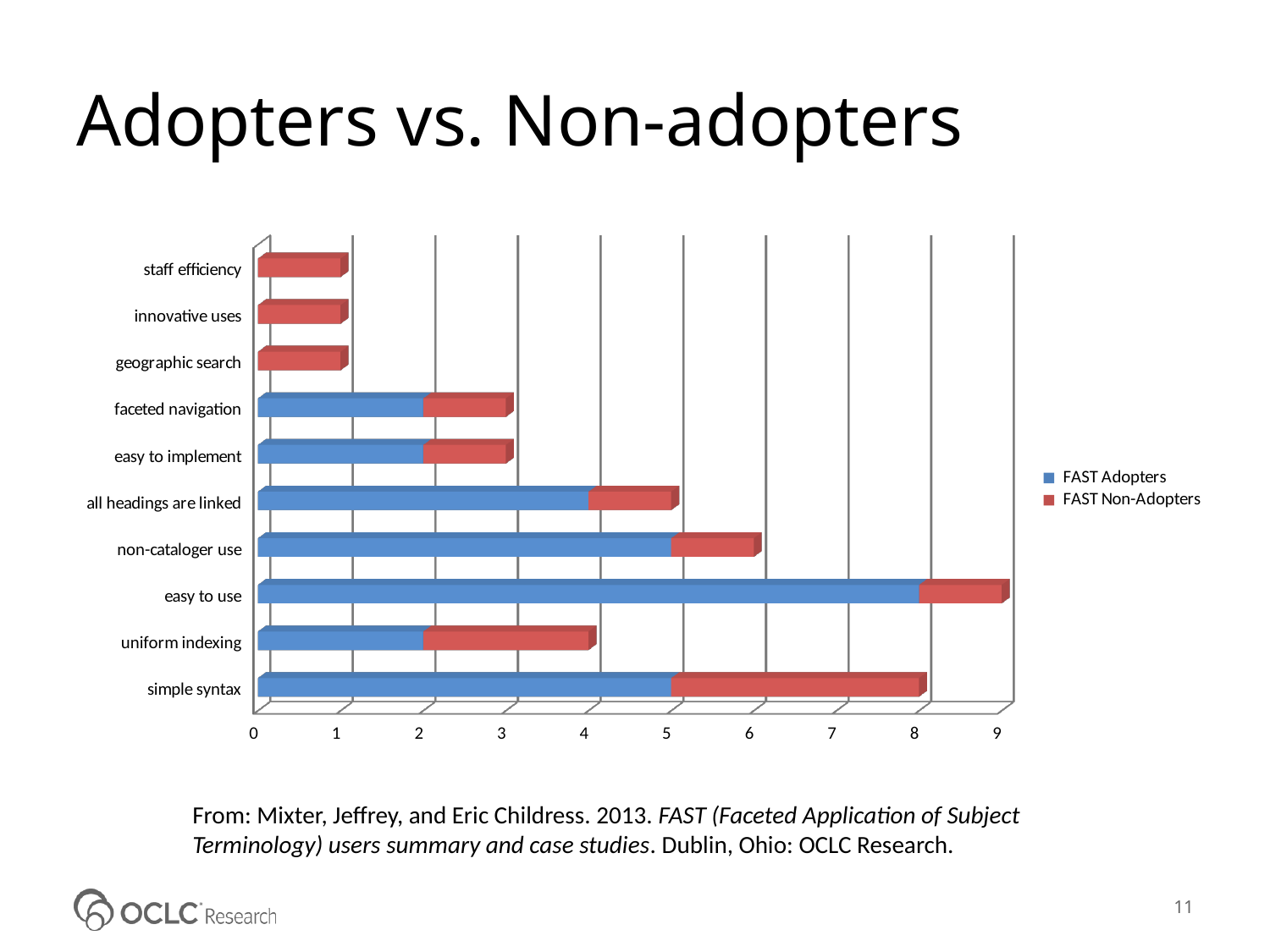
What is the FAST Adopters value for 'easy to use'? 8 Which has a larger total bar, 'simple syntax' or 'uniform indexing'? simple syntax Is the total bar for 'non-cataloger use' greater or less than 5? greater What is the FAST Adopters value for 'uniform indexing'? 2 What is the total of the stacked bar for 'simple syntax'? 8 What kind of chart is shown on the slide? bar chart How many series does the legend list? 2 Which category has the longest total bar? easy to use What is the total of the stacked bar for 'easy to use'? 9 How many categories are plotted on the chart? 10 Which series is shown in red in the legend? FAST Non-Adopters What is the FAST Adopters value for 'simple syntax'? 5